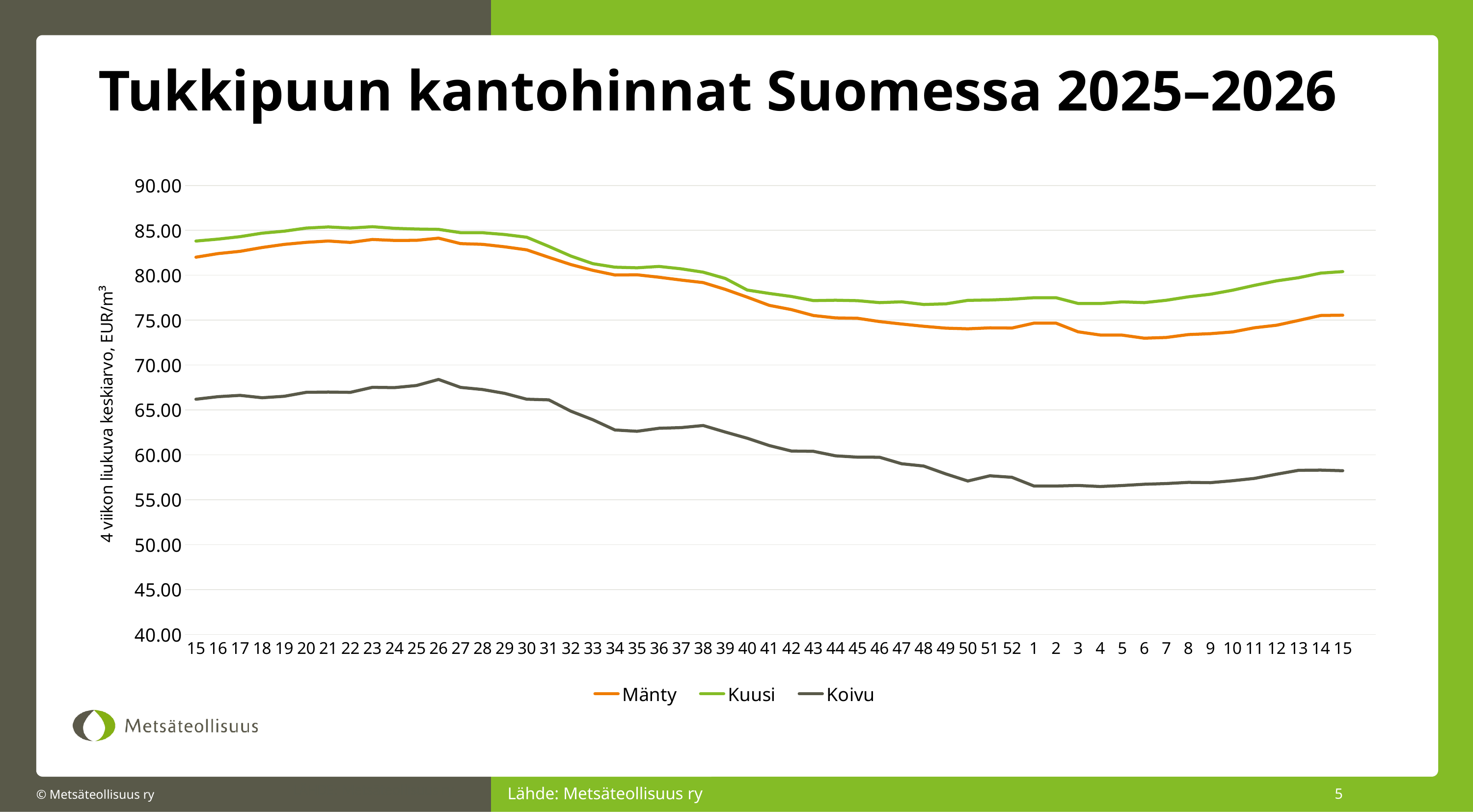
At week 40, which series has the higher value, Kuusi or Mänty? Kuusi What kind of chart is shown on the slide? line chart Is the value for Mänty at week 7 greater or less than 75.00? less Is the value for Kuusi at the first week 15 greater or less than 80.00? greater How many series does the legend list? 3 Does the Koivu line rise or fall from week 26 to week 1? fall Is the value for Koivu at week 1 greater or less than 60.00? less Which series are listed in the legend? Mänty, Kuusi, Koivu Which series has the lowest values across the whole chart? Koivu What is the title of the chart on the slide? Tukkipuun kantohinnat Suomessa 2025–2026 Which series has the highest values across the whole chart? Kuusi